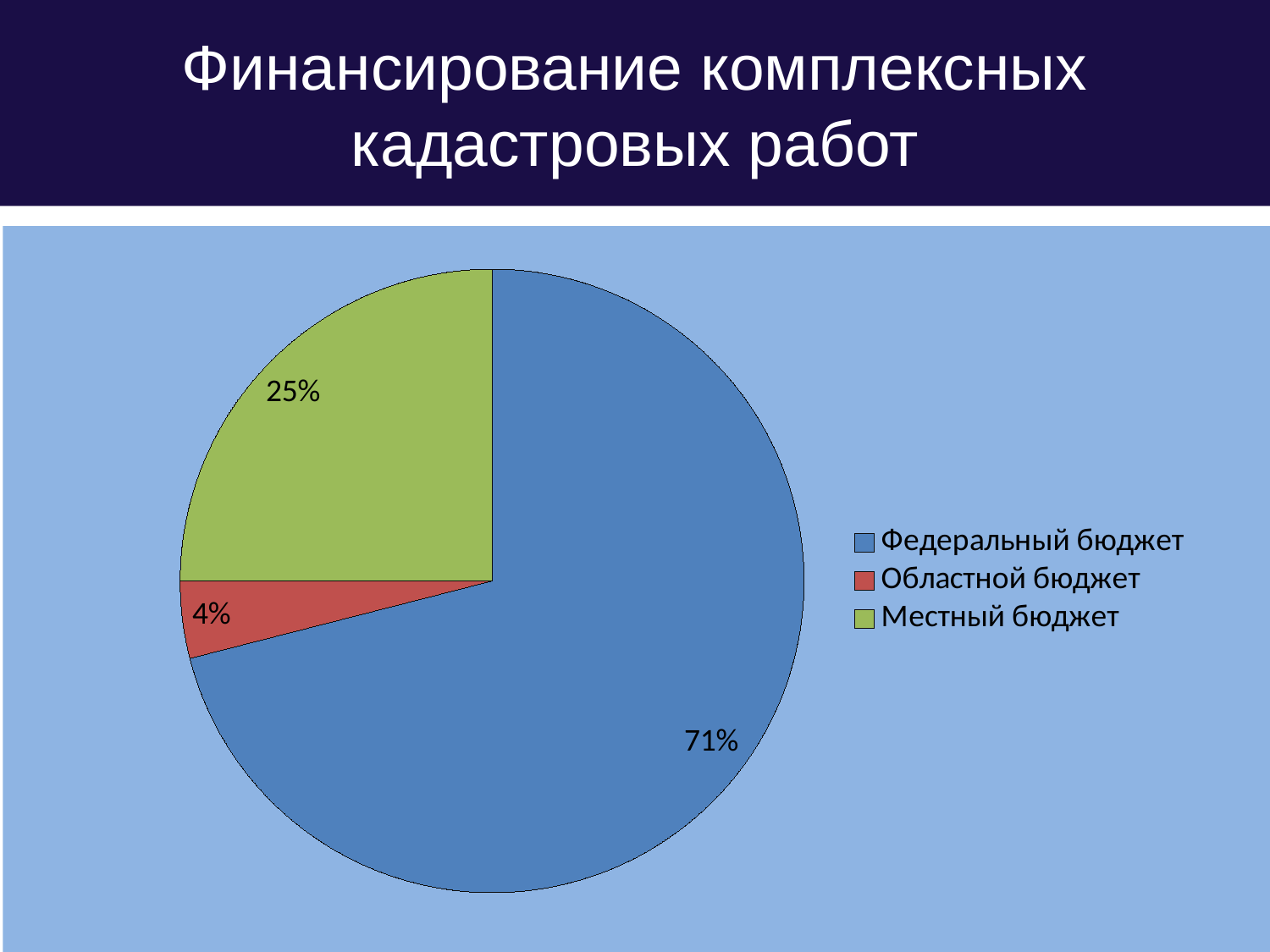
How many categories does the pie chart have? 3 Which category has the smallest slice of the pie? Областной бюджет What share of the pie does Федеральный бюджет have? 71% Which category has the largest slice of the pie? Федеральный бюджет What is the title of the slide containing the chart? Финансирование комплексных кадастровых работ What is the difference between the shares of Федеральный бюджет and Местный бюджет? 46% What colour is the slice for Местный бюджет? green Which is larger, the share of Местный бюджет or the share of Областной бюджет? Местный бюджет What is the difference between the shares of Местный бюджет and Областной бюджет? 21% What kind of chart is shown on the slide? pie chart What share of the pie does Областной бюджет have? 4% What share of the pie does Местный бюджет have? 25%